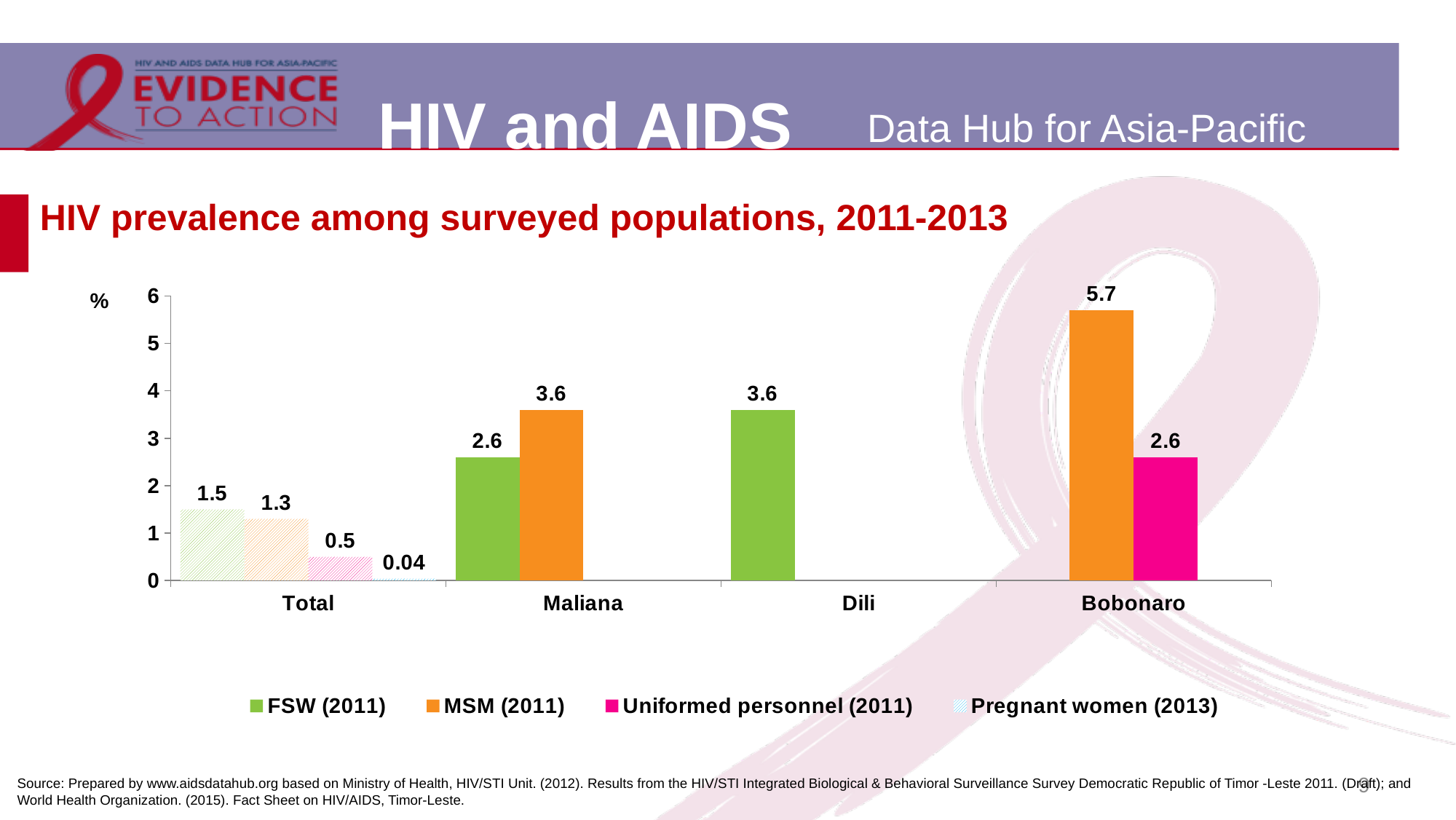
What is the HIV prevalence for MSM (2011) in Bobonaro? 5.7 How many categories are shown on the x axis? 4 What is the title of the chart? HIV prevalence among surveyed populations, 2011-2013 What kind of chart is shown on the slide? Bar chart Which category has the highest value for MSM (2011)? Bobonaro Which is larger in Maliana: the FSW (2011) value or the MSM (2011) value? MSM (2011) How many series does the legend list? 4 What is the difference between the MSM (2011) value and the Uniformed personnel (2011) value in Bobonaro? 3.1 Which series has the lowest value in the Total category? Pregnant women (2013) What is the HIV prevalence for Pregnant women (2013) in the Total category? 0.04 What is the HIV prevalence for FSW (2011) in Maliana? 2.6 What is the HIV prevalence for Uniformed personnel (2011) in Bobonaro? 2.6